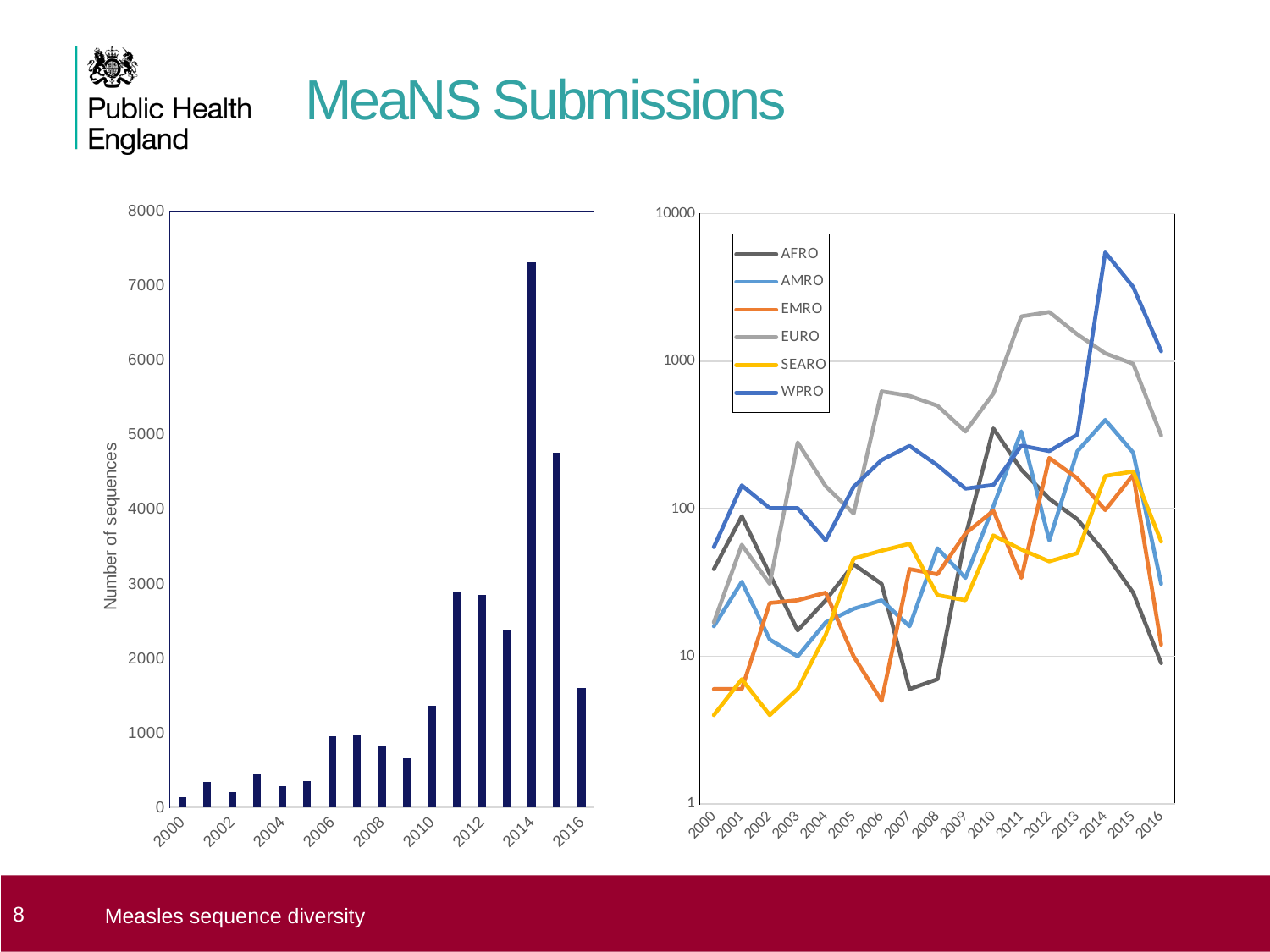
In the bar chart on the left, which year has the highest number of sequences? 2014 In the bar chart on the left, is the value for 2014 greater or less than 7000? greater In the bar chart on the left, how many years are shown on the x axis? 17 How many series does the legend of the line chart on the right list? 6 What kind of chart is the chart on the right of the slide? line chart In the line chart on the right, which series has the highest value in 2014? WPRO In the bar chart on the left, is the value for 2016 greater or less than 2000? less In the bar chart on the left, is the value for 2010 greater or less than 1000? greater What kind of chart is the chart on the left of the slide? bar chart In the bar chart on the left, which year has the lowest number of sequences? 2000 In the line chart on the right, which is larger in 2010, AFRO or SEARO? AFRO